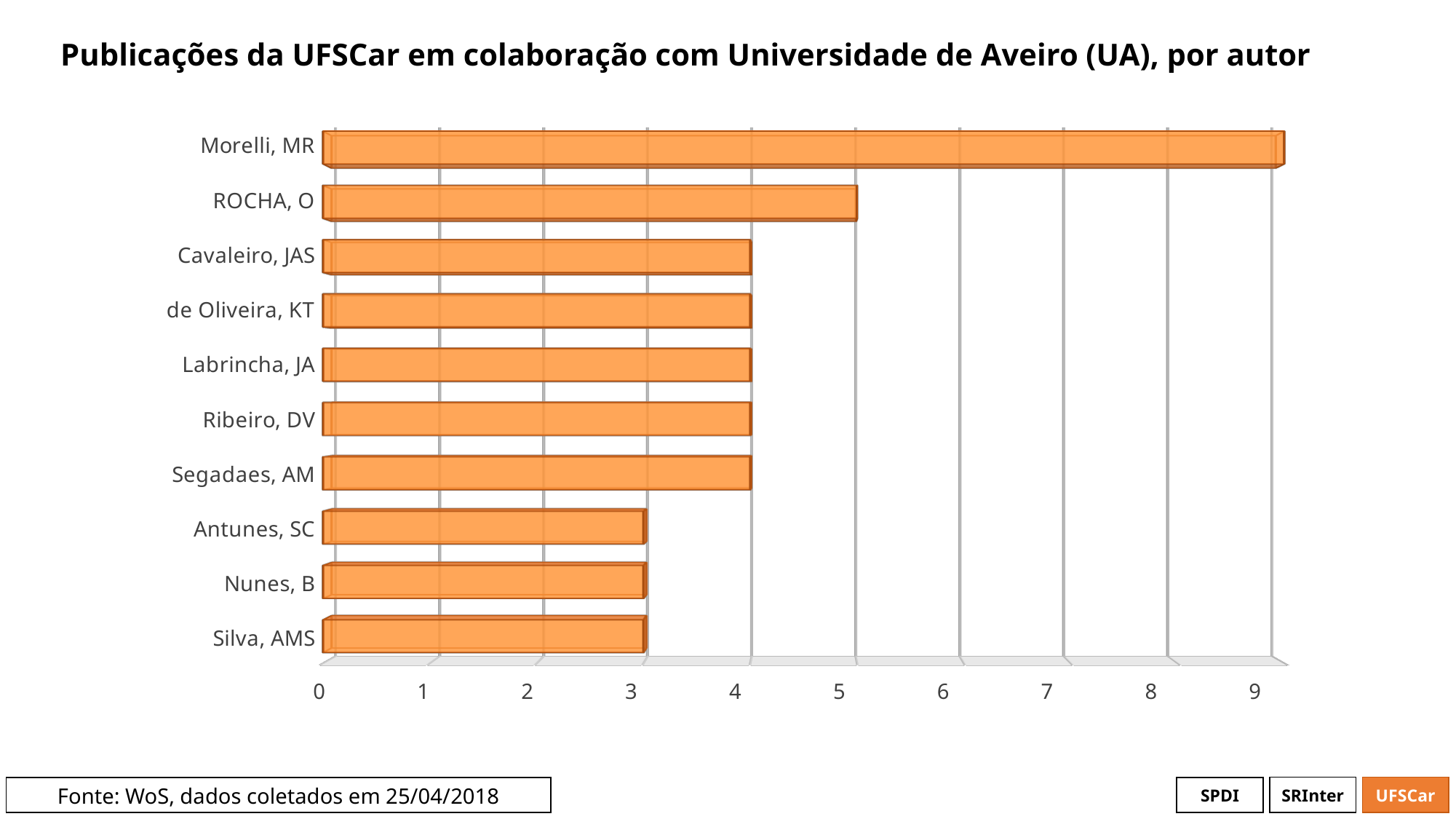
What kind of chart is shown on the slide? bar chart What is the title of the chart? Publicações da UFSCar em colaboração com Universidade de Aveiro (UA), por autor How many publications does ROCHA, O have according to the chart? 5 How many publications does Silva, AMS have according to the chart? 3 What is the difference in publications between ROCHA, O and Antunes, SC? 2 Which has more publications, Nunes, B or Segadaes, AM? Segadaes, AM Is the value for Morelli, MR greater or less than 8? greater Which author has the highest number of publications in collaboration with Universidade de Aveiro? Morelli, MR How many authors are listed in the chart? 10 Which has more publications, ROCHA, O or Labrincha, JA? ROCHA, O Is the value for Antunes, SC greater or less than 4? less How many publications does Cavaleiro, JAS have according to the chart? 4